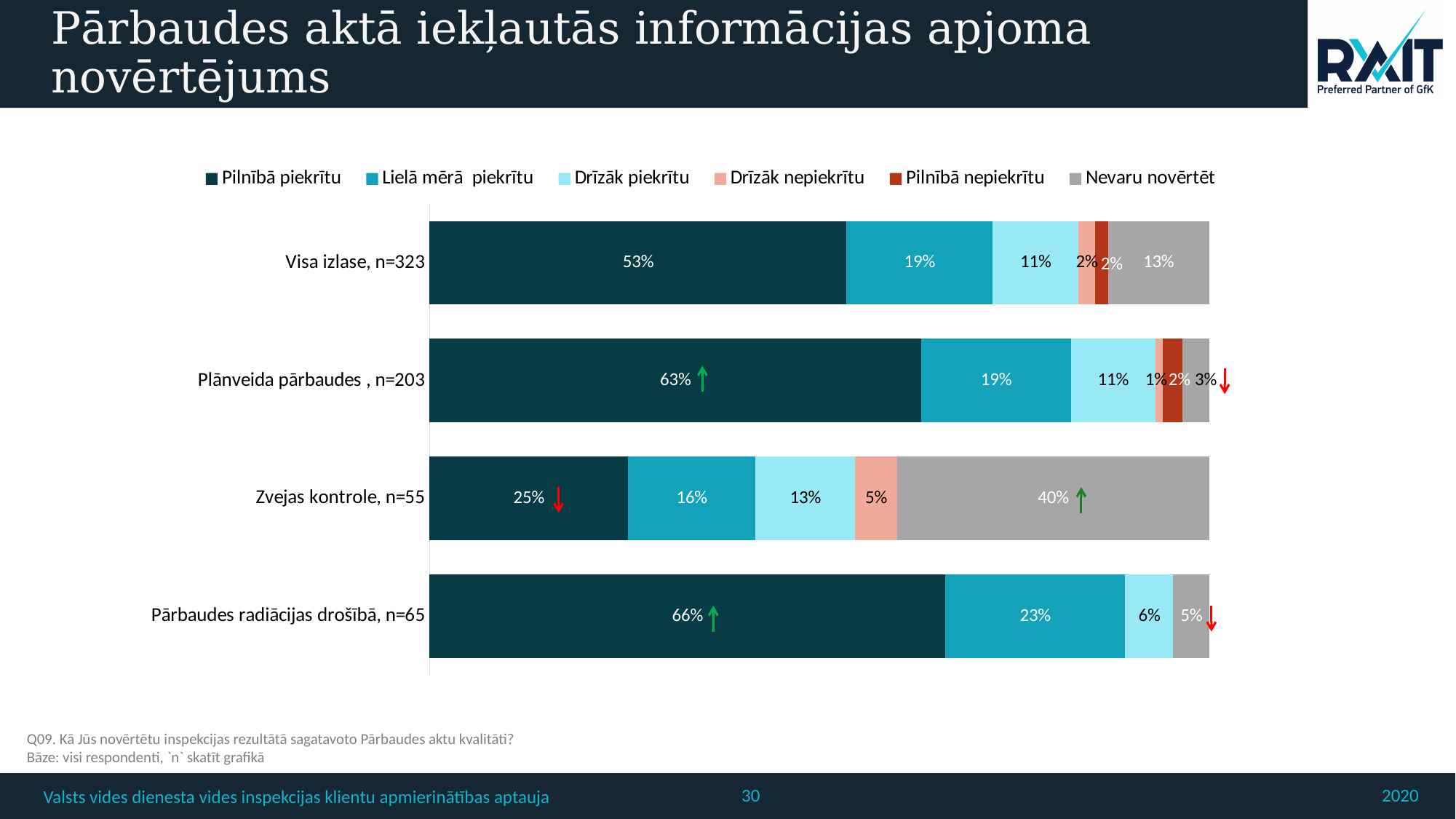
Which is larger: the 'Nevaru novērtēt' value for 'Visa izlase, n=323' or for 'Plānveida pārbaudes, n=203'? Visa izlase, n=323 What is the 'Lielā mērā piekrītu' value for 'Pārbaudes radiācijas drošībā, n=65'? 23% What kind of chart is shown on the slide? Stacked bar chart What colour represents 'Nevaru novērtēt' in the legend? Grey Which category has the highest 'Pilnībā piekrītu' value? Pārbaudes radiācijas drošībā, n=65 How many series does the legend list? 6 How many categories (bars) are plotted in the chart? 4 What is the difference between the 'Pilnībā piekrītu' values for 'Plānveida pārbaudes, n=203' and 'Visa izlase, n=323'? 10% What is the 'Pilnībā piekrītu' value for 'Visa izlase, n=323'? 53% What is the 'Drīzāk piekrītu' value for 'Plānveida pārbaudes, n=203'? 11% What is the 'Nevaru novērtēt' value for 'Zvejas kontrole, n=55'? 40% Which category has the lowest 'Pilnībā piekrītu' value? Zvejas kontrole, n=55